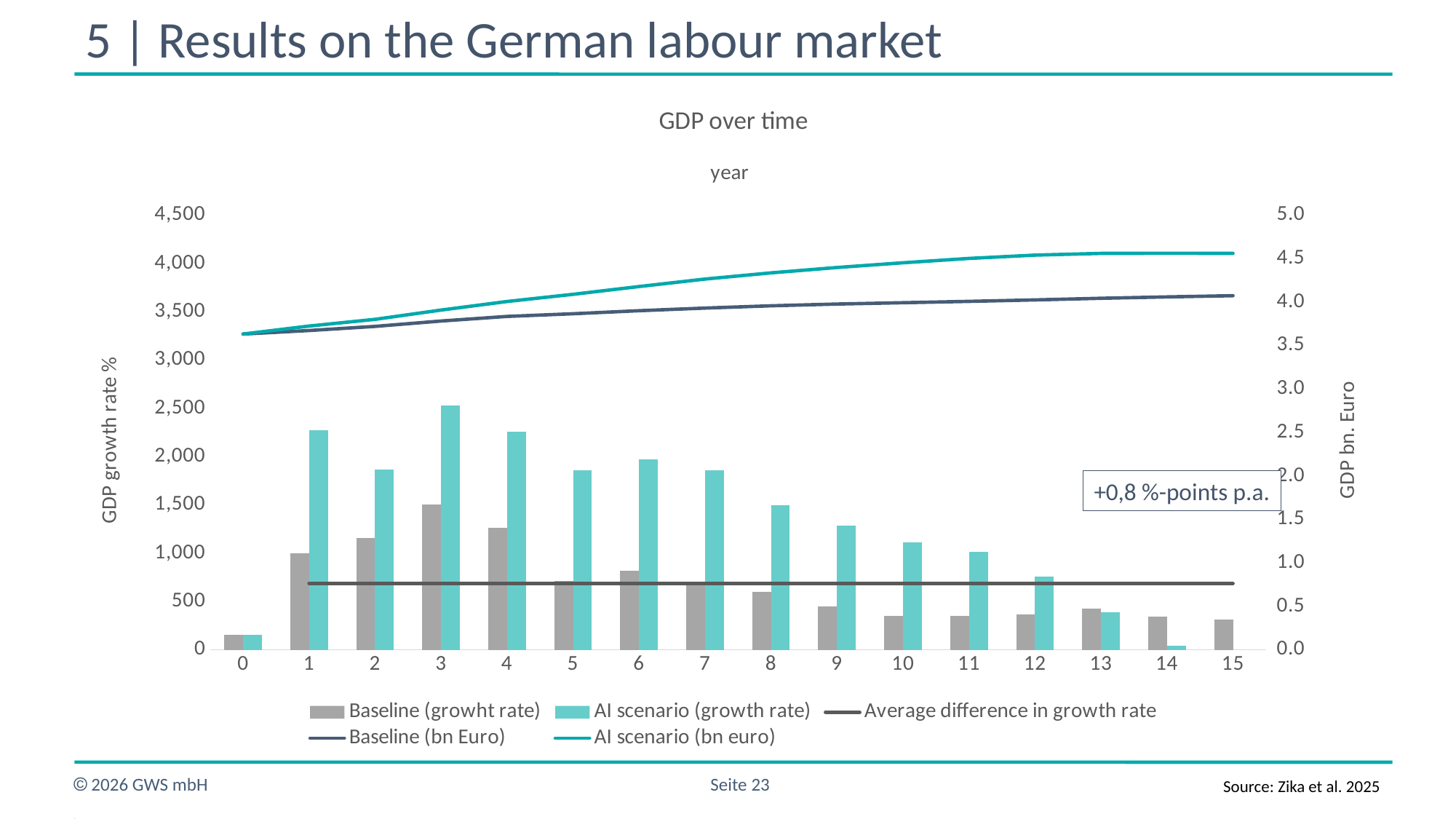
Does the AI scenario (bn euro) line rise or fall from year 0 to year 15? rise What is the title of the chart? GDP over time In which year is the AI scenario (growth rate) bar highest? 3 How many years are shown on the x axis of the chart? 16 In which year is the AI scenario (growth rate) bar lowest? 15 What kind of chart is shown on the slide? bar and line chart Is the AI scenario (growth rate) value for year 3 greater or less than 2,000 on the left axis? greater Is the AI scenario (bn euro) line at year 15 greater or less than 4.0 on the right axis? greater In year 1, which bar is taller: Baseline (growht rate) or AI scenario (growth rate)? AI scenario (growth rate) How many series does the chart legend list? 5 What value does the text box on the chart give for the average difference in growth rate? +0,8 %-points p.a. In which year is the Baseline (growht rate) bar highest? 3